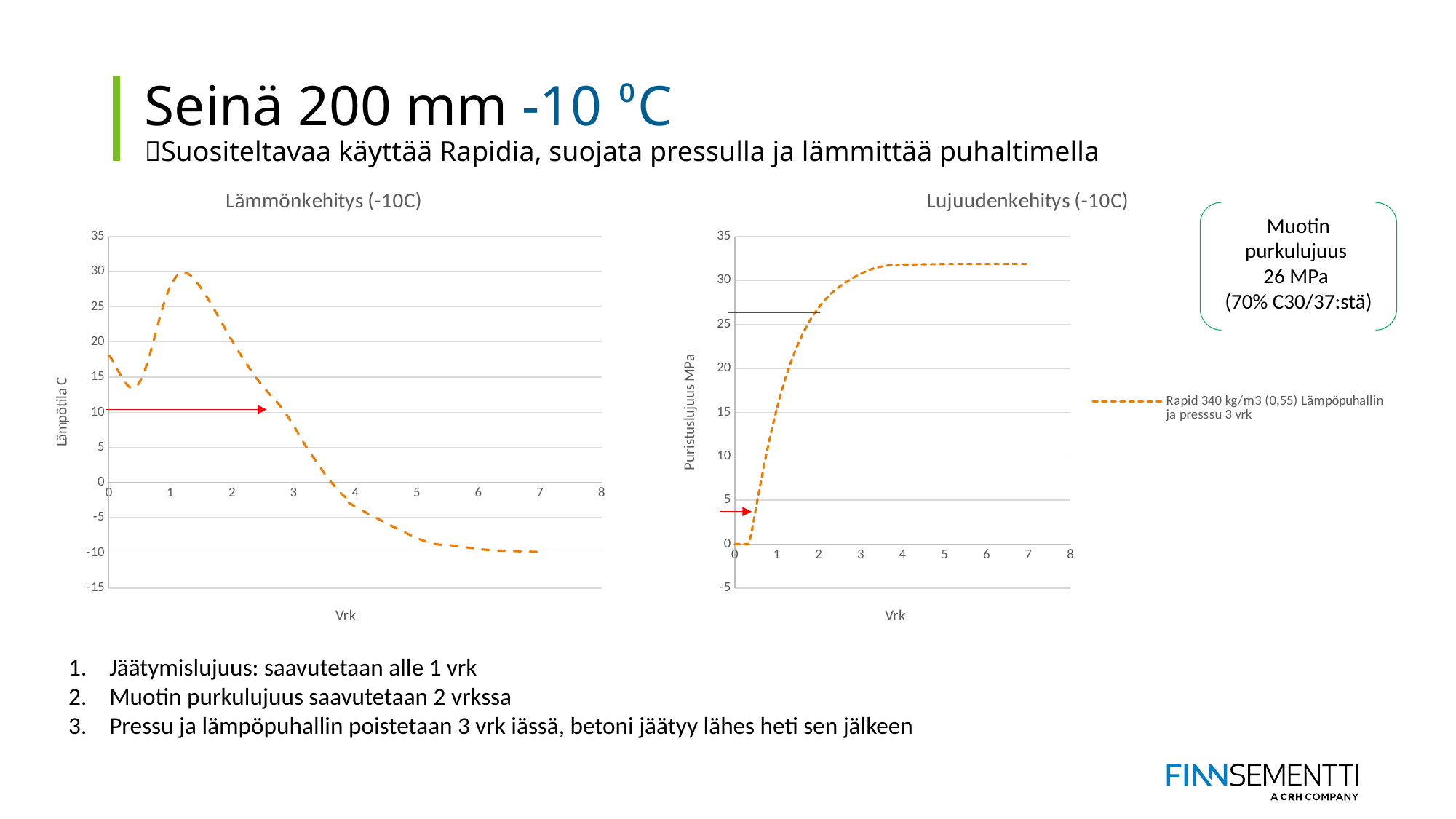
In the 'Lämmönkehitys (-10C)' chart, is the value at 7 vrk greater or less than -5? less What kind of chart is the 'Lämmönkehitys (-10C)' chart on the left? line chart In the 'Lujuudenkehitys (-10C)' chart, do the values generally rise or fall as vrk increases? rise In the 'Lämmönkehitys (-10C)' chart, is the value at 5 vrk greater or less than 0? less In the 'Lujuudenkehitys (-10C)' chart, is the value at 4 vrk greater or less than 30? greater What is the y-axis label of the 'Lujuudenkehitys (-10C)' chart? Puristuslujuus MPa What kind of chart is the 'Lujuudenkehitys (-10C)' chart on the right? line chart How many series does the legend of the 'Lujuudenkehitys (-10C)' chart list? 1 In the 'Lämmönkehitys (-10C)' chart, do the values rise or fall between 2 vrk and 7 vrk? fall